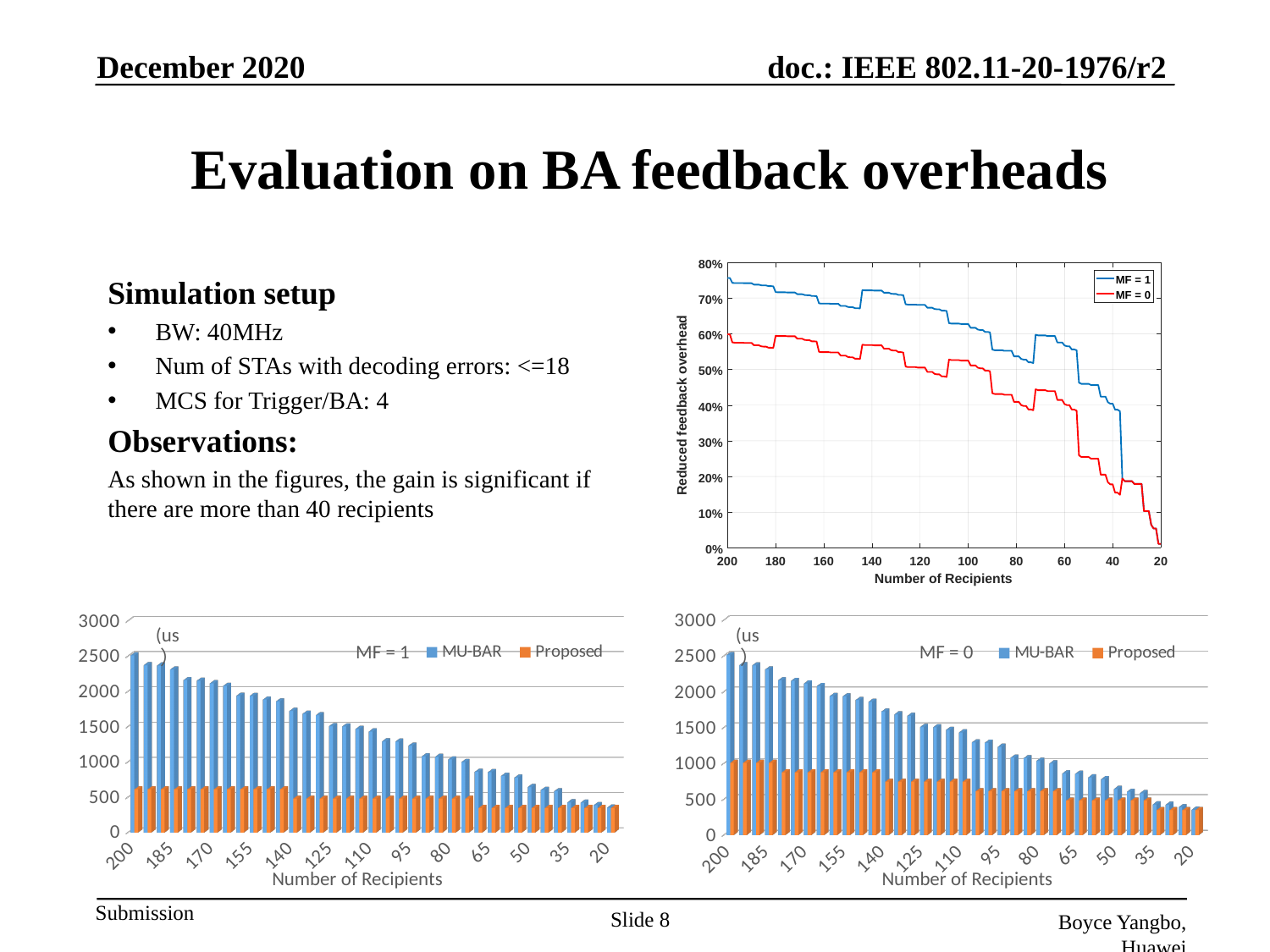
In the top-right line chart, is the MF = 1 value at 20 recipients greater or less than 10%? less In the bottom-right chart titled MF = 0, which series is larger at 200 recipients, MU-BAR or Proposed? MU-BAR How many series does the legend of the top-right line chart list? 2 In the top-right line chart, is the MF = 0 value at 200 recipients greater or less than 50%? greater In the bottom-right chart titled MF = 0, what are the two series named in the legend? MU-BAR and Proposed In the top-right line chart, do the values rise or fall moving from left to right along the x axis? fall In the bottom-left chart titled MF = 1, is the MU-BAR value at 200 recipients greater or less than 2000? greater What type of chart is the top-right chart with the y-axis 'Reduced feedback overhead'? line chart What is the x-axis title of the top-right line chart? Number of Recipients In the top-right line chart, which series is higher at 100 recipients, MF = 1 or MF = 0? MF = 1 What type of chart is the bottom-left chart titled MF = 1? bar chart